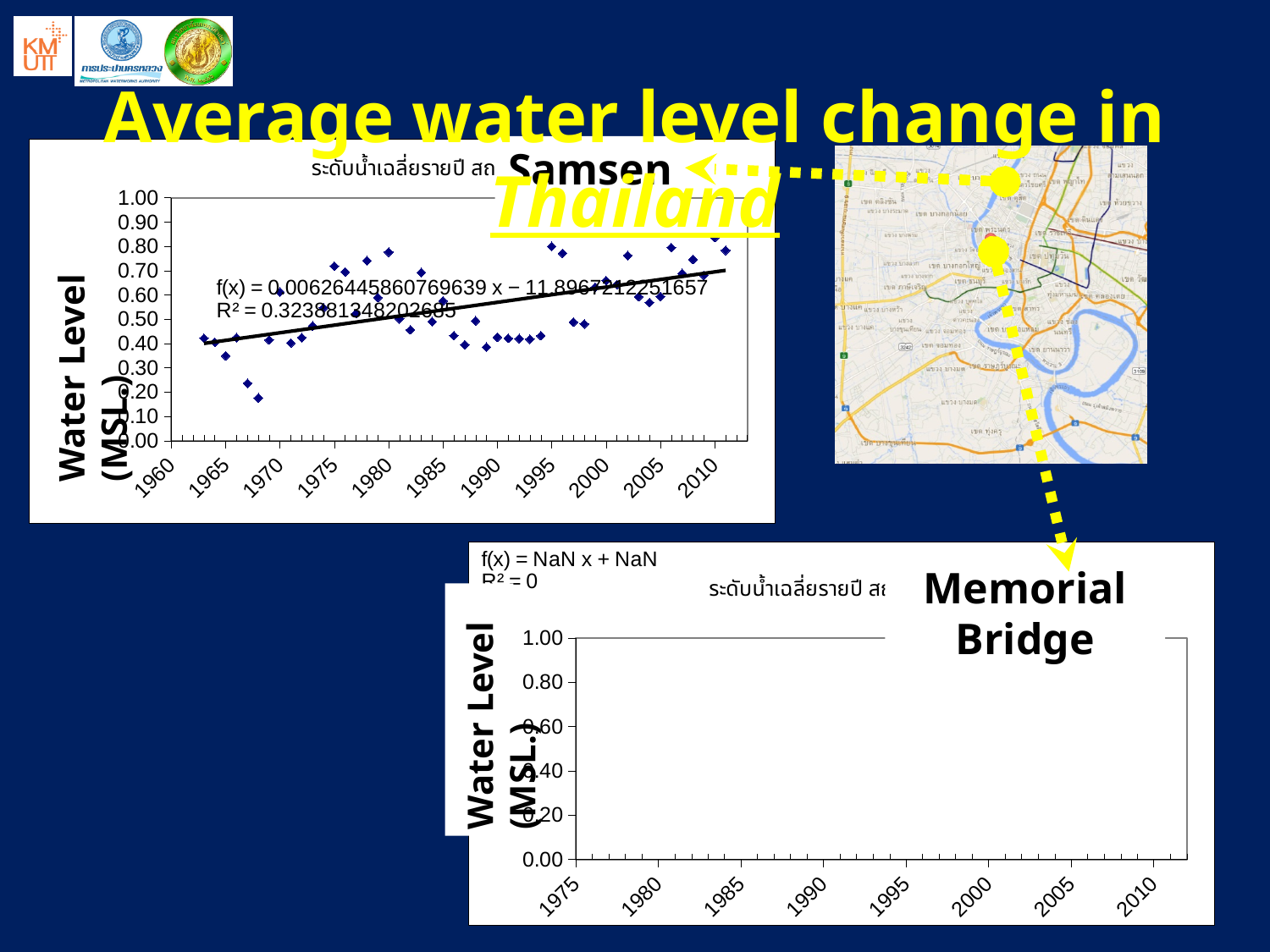
On the Samsen chart, does the fitted trend line rise or fall from 1960 to 2010? rises What is the maximum value shown on the y-axis of the Memorial Bridge chart? 1.00 What is the first year tick on the x-axis of the Memorial Bridge chart? 1975 What is the y-axis label on the Samsen chart? Water Level (MSL.) What R² value is printed on the Samsen chart? R² = 0.323881348202685 On the Samsen chart, which is higher: the water level around 1968 or the water level around 1980? around 1980 On the Samsen chart, is the lowest plotted water level around 1968 greater or less than 0.30? less What kind of chart is the Samsen chart (top left)? scatter chart What is the first year tick on the x-axis of the Samsen chart? 1960 On the Samsen chart, is the highest plotted water level around 1980 greater or less than 0.70? greater How many data points are plotted on the Memorial Bridge chart (bottom right)? 0